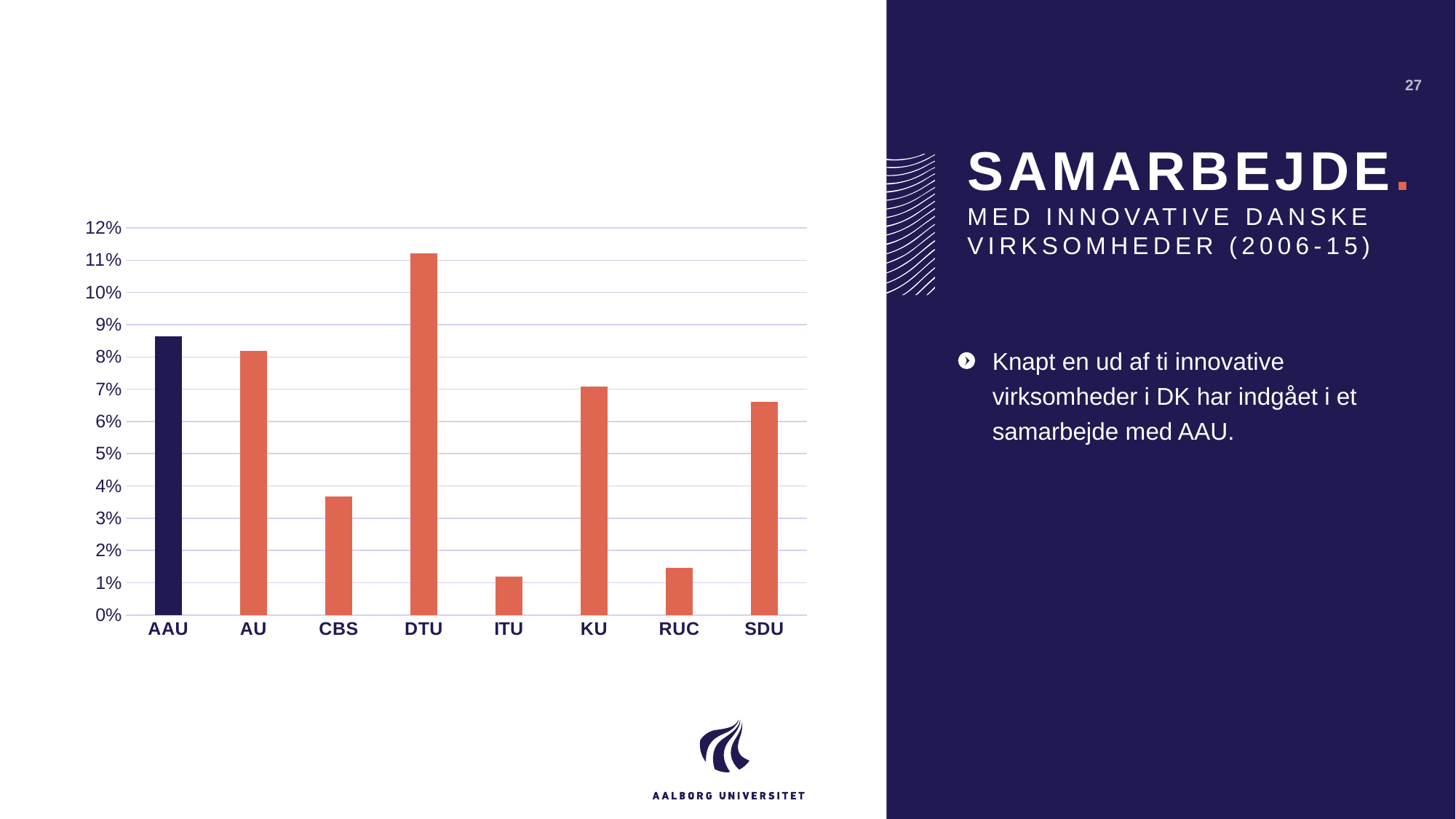
Is the value for CBS greater or less than 4%? less Which university has the highest bar in the chart? DTU Which has the larger value, DTU or AAU? DTU Is the value for ITU greater or less than 2%? less How many universities are shown on the x axis of the chart? 8 Is the value for AAU greater or less than 8%? greater Which bar in the chart is coloured dark navy instead of orange? AAU Which has the larger value, CBS or KU? KU What kind of chart is shown on the slide? bar chart